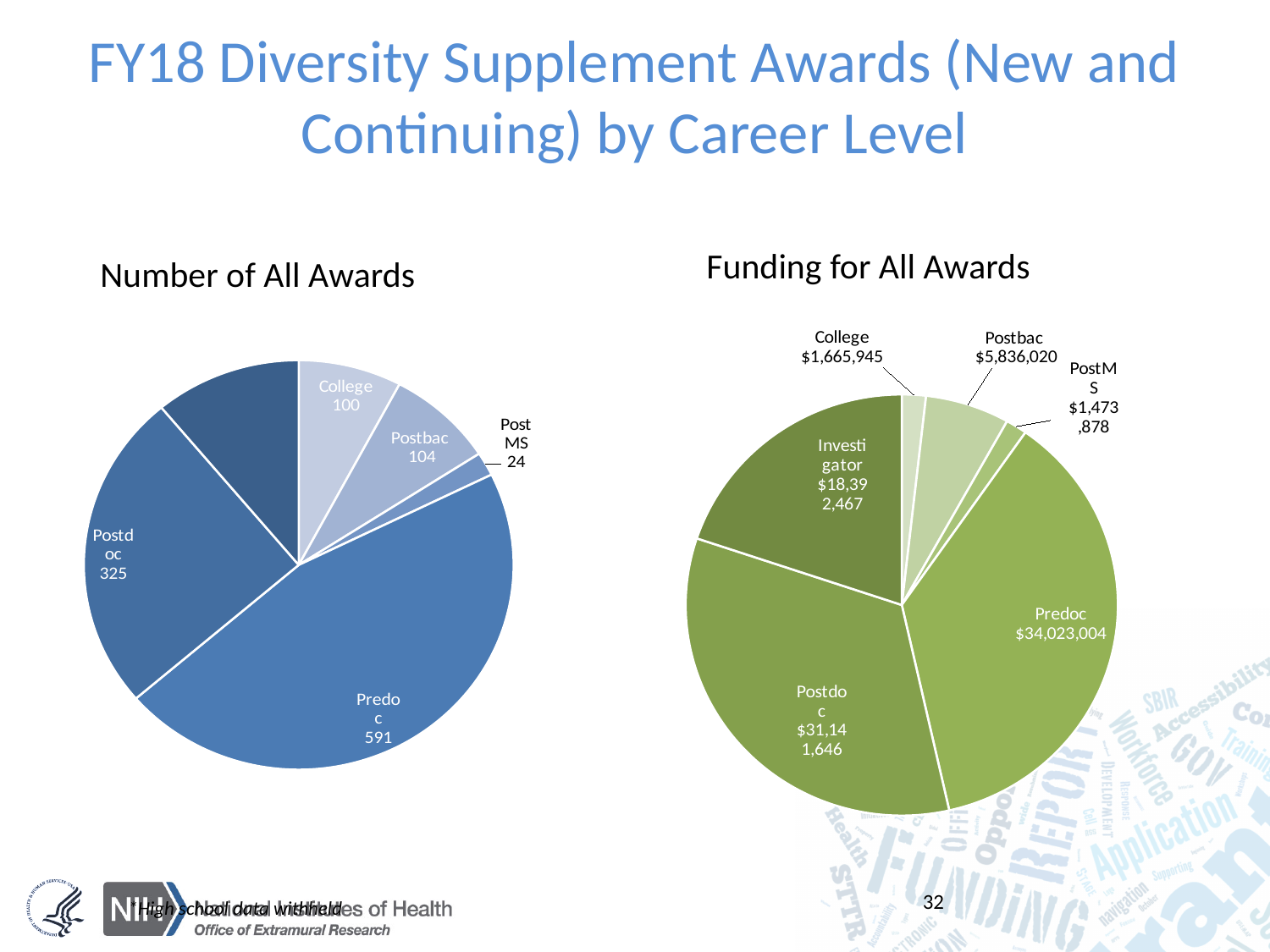
In the 'Number of All Awards' chart, what is the difference between the Predoc and Postdoc award counts? 266 What type of chart is used for 'Funding for All Awards'? Pie chart In the 'Number of All Awards' chart, what is the value for PostMS? 24 In the 'Number of All Awards' chart, how many Predoc awards are shown? 591 In the 'Number of All Awards' chart, which has more awards, Postbac or College? Postbac In the 'Funding for All Awards' chart, how much more funding does Predoc have than Postdoc? $2,881,358 In the 'Funding for All Awards' chart, what is the funding amount for Postbac? $5,836,020 In the 'Funding for All Awards' chart, what is the funding amount for Predoc? $34,023,004 In the 'Funding for All Awards' chart, what is the funding amount for Investigator? $18,392,467 In the 'Number of All Awards' chart, what is the value for Postdoc? 325 In the 'Funding for All Awards' chart, which career level has the smallest funding? PostMS In the 'Funding for All Awards' chart, which career level has the largest funding? Predoc